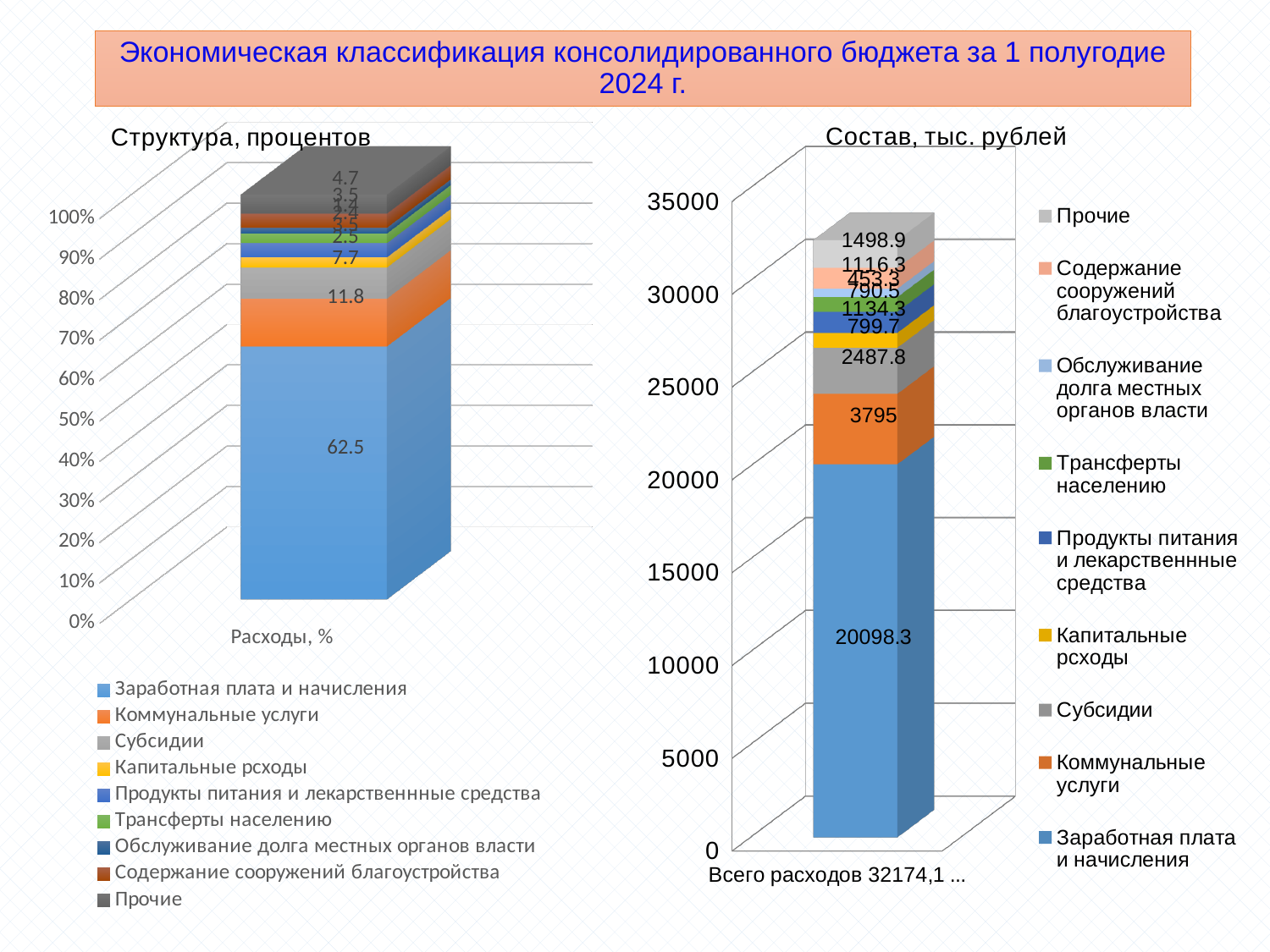
In the chart titled "Структура, процентов", what percentage is shown for Заработная плата и начисления? 62.5 In the chart titled "Состав, тыс. рублей", which is larger: Продукты питания и лекарственные средства or Содержание сооружений благоустройства? Продукты питания и лекарственные средства In the chart titled "Состав, тыс. рублей", what value is shown for Коммунальные услуги? 3795 How many series does the legend of the chart titled "Состав, тыс. рублей" list? 9 In the chart titled "Состав, тыс. рублей", which expense category has the largest value? Заработная плата и начисления In the chart titled "Состав, тыс. рублей", what value is shown for Заработная плата и начисления? 20098.3 In the chart titled "Состав, тыс. рублей", which expense category has the smallest value? Обслуживание долга местных органов власти In the chart titled "Структура, процентов", what value is shown for Коммунальные услуги? 11.8 What kind of chart is the chart titled "Структура, процентов"? Stacked bar chart In the chart titled "Состав, тыс. рублей", what is the difference between Коммунальные услуги and Субсидии? 1307.2 In the chart titled "Состав, тыс. рублей", what value is shown for Прочие? 1498.9 In the chart titled "Структура, процентов", what value is shown for Субсидии? 7.7